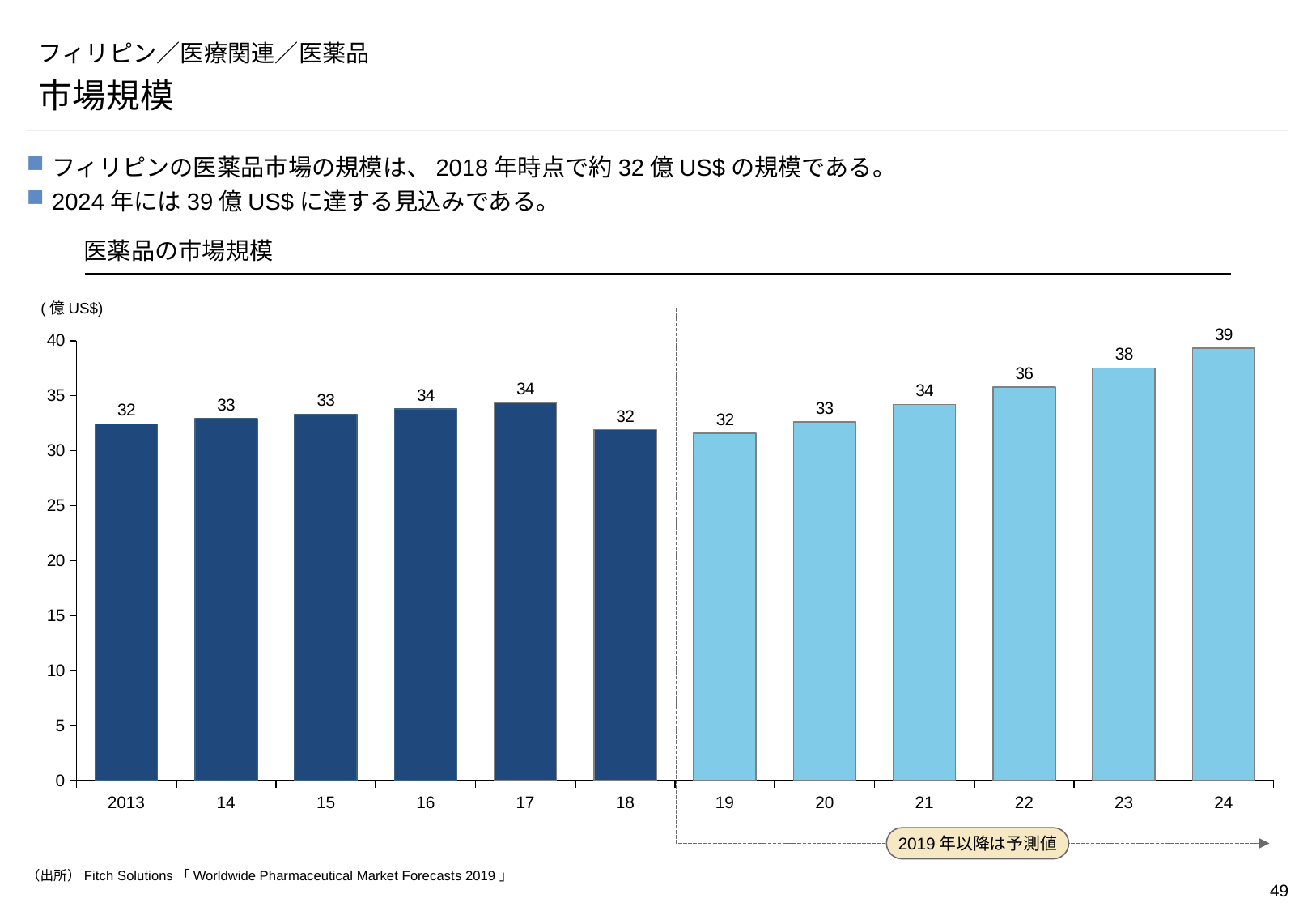
Which year has the highest value in the 医薬品の市場規模 chart? 24 What is the difference between the values for 24 and 2013 in the 医薬品の市場規模 chart? 7 What is the value for 24 in the 医薬品の市場規模 chart? 39 What is the value for 22 in the 医薬品の市場規模 chart? 36 What is the value for 17 in the 医薬品の市場規模 chart? 34 Do the values in the 医薬品の市場規模 chart rise or fall from 19 to 24? rise What kind of chart is the 医薬品の市場規模 chart? bar chart How many years are shown on the x axis of the 医薬品の市場規模 chart? 12 Is the value for 18 in the 医薬品の市場規模 chart greater or less than 30? greater What is the value for 2013 in the 医薬品の市場規模 chart? 32 Which is larger in the 医薬品の市場規模 chart, the value for 23 or the value for 2013? 23 What unit is shown on the y axis of the 医薬品の市場規模 chart? 億 US$